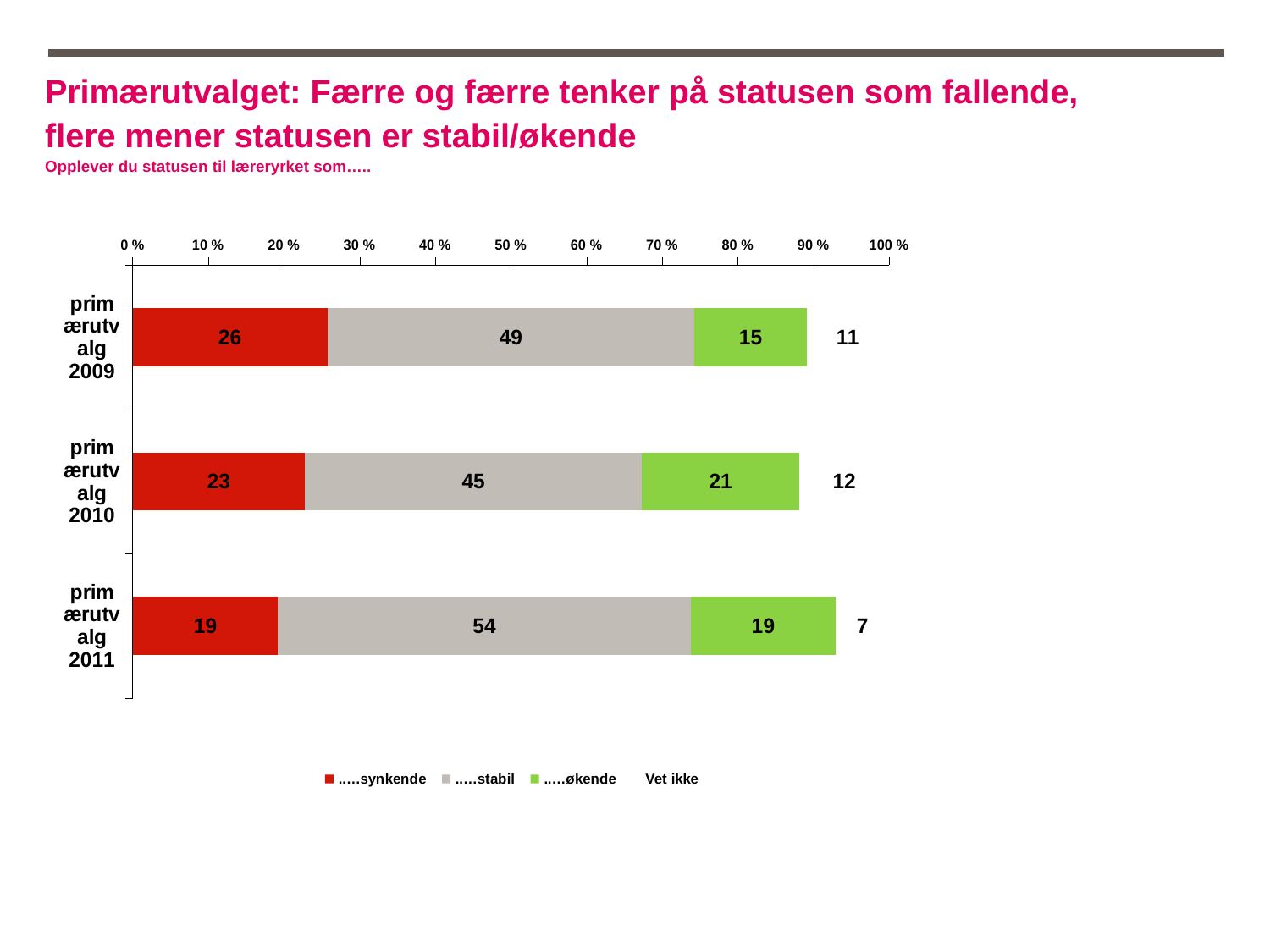
How many series does the legend list? 4 What kind of chart is shown on the slide? Stacked bar chart Which year has the highest value for "stabil"? primærutvalg 2011 Which year has the lowest value for "synkende"? primærutvalg 2011 Which is larger: the "økende" value for primærutvalg 2010 or for primærutvalg 2009? primærutvalg 2010 What is the value for "økende" for primærutvalg 2010? 21 Does the "synkende" value rise or fall from 2009 to 2011? Fall What is the value for "synkende" for primærutvalg 2009? 26 How many categories (years) are shown on the chart? 3 What is the difference between the "synkende" values for primærutvalg 2009 and primærutvalg 2011? 7 What is the value for "stabil" for primærutvalg 2011? 54 What is the value for "Vet ikke" for primærutvalg 2011? 7